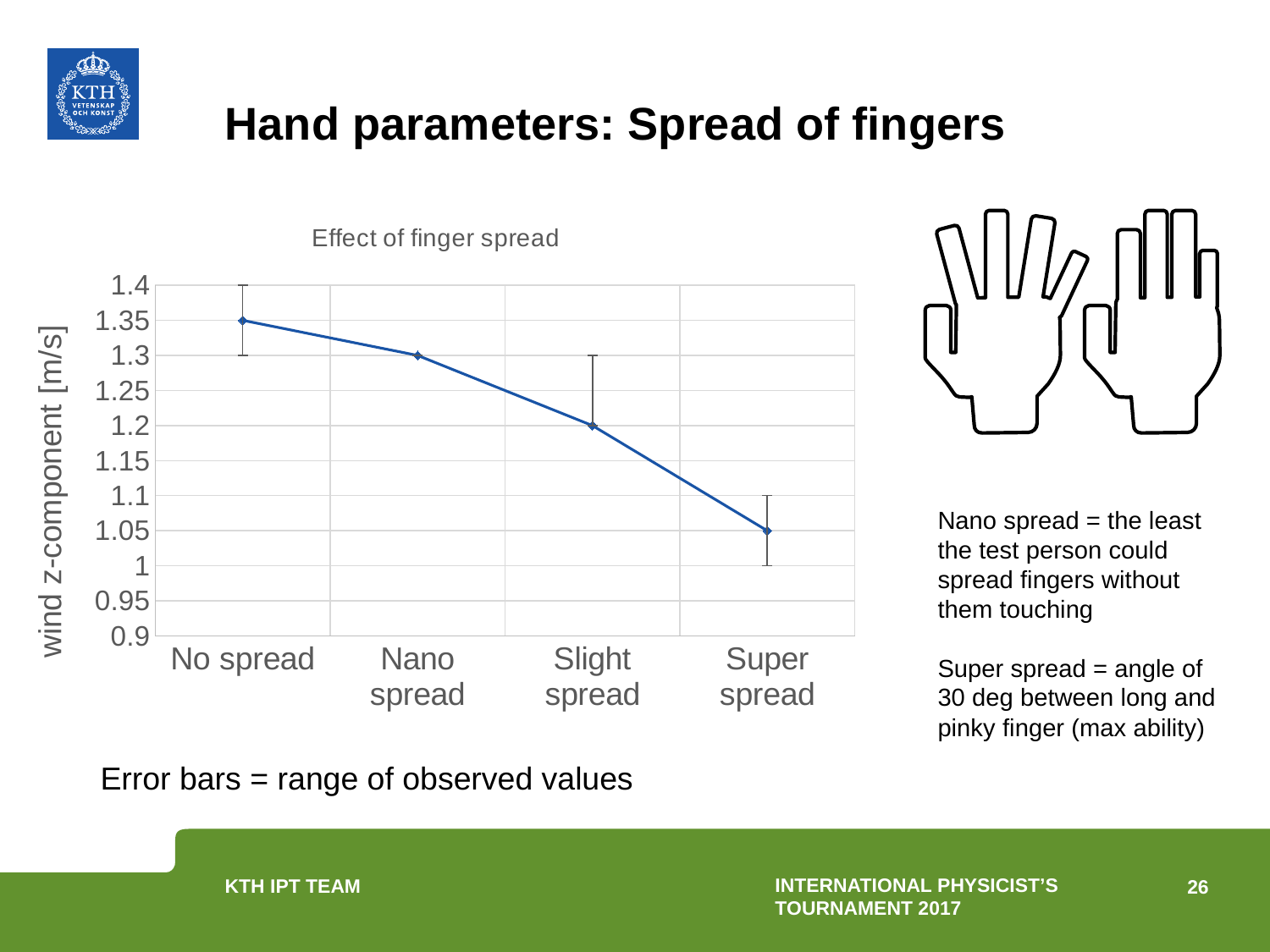
What is the title of the chart? Effect of finger spread Which category has the lowest wind z-component? Super spread What kind of chart is shown on the slide? line chart Which has a larger wind z-component, Nano spread or Slight spread? Nano spread What is the difference between the wind z-component for No spread and Super spread? 0.3 How many categories are plotted on the x axis of the chart? 4 Which category has the highest wind z-component? No spread What is the wind z-component value for No spread? 1.35 Do the values rise or fall from No spread to Super spread along the x axis? fall What is the wind z-component value for Slight spread? 1.2 What is the wind z-component value for Nano spread? 1.3 What is the wind z-component value for Super spread? 1.05